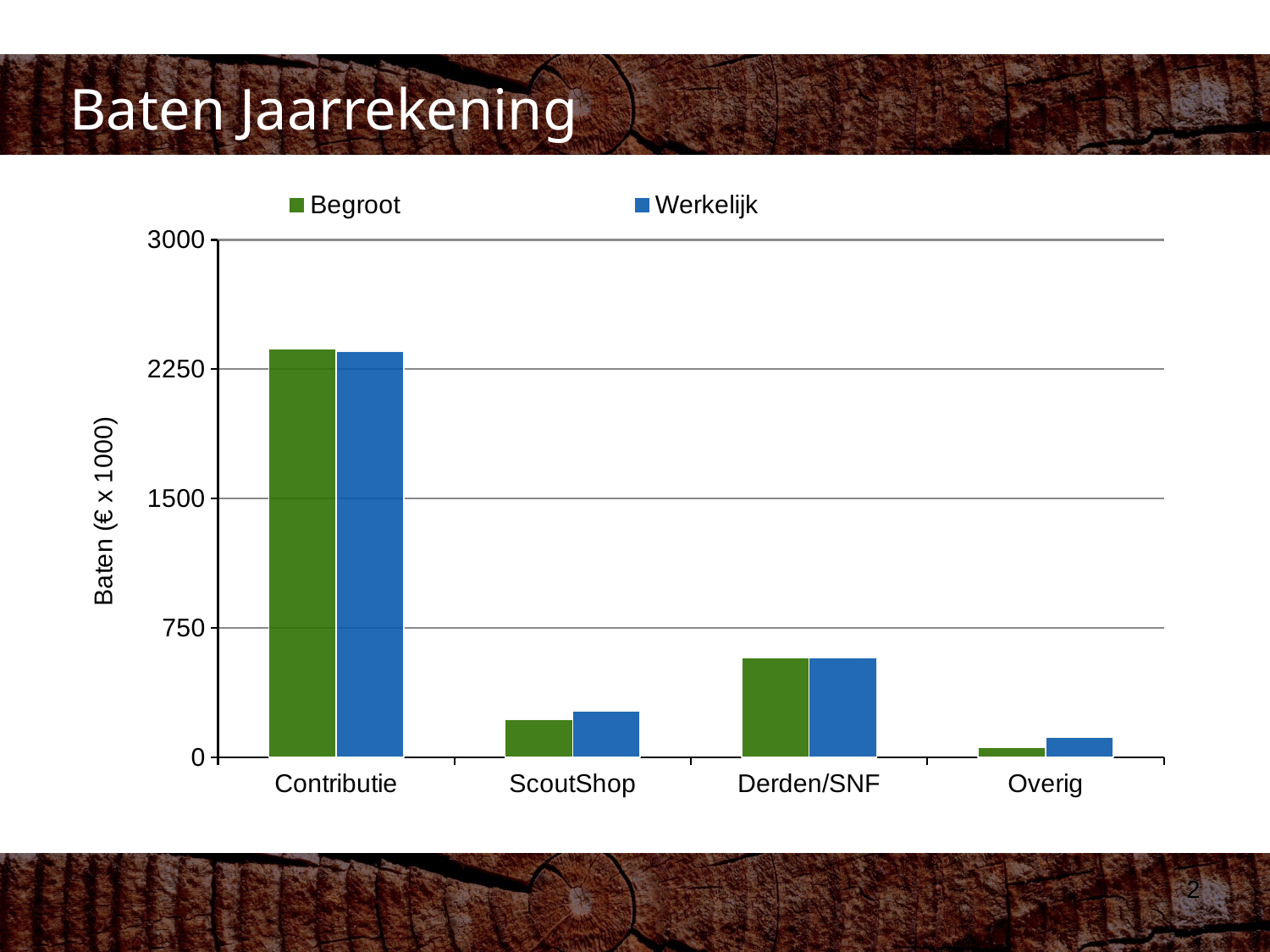
Is the Werkelijk value for Derden/SNF greater or less than 750? less What kind of chart is shown on the slide? bar chart For ScoutShop, which is larger: the Begroot value or the Werkelijk value? Werkelijk Is the Werkelijk value for ScoutShop greater or less than 750? less How many series does the chart's legend list? 2 Which series is shown in green in the chart? Begroot What is the title of the chart's vertical axis? Baten (€ x 1000) Which category has the highest Begroot value? Contributie For Overig, which is larger: the Begroot value or the Werkelijk value? Werkelijk Which category has the lowest Werkelijk value? Overig Is the Begroot value for Contributie greater or less than 2250? greater How many categories are shown on the x axis of the chart? 4